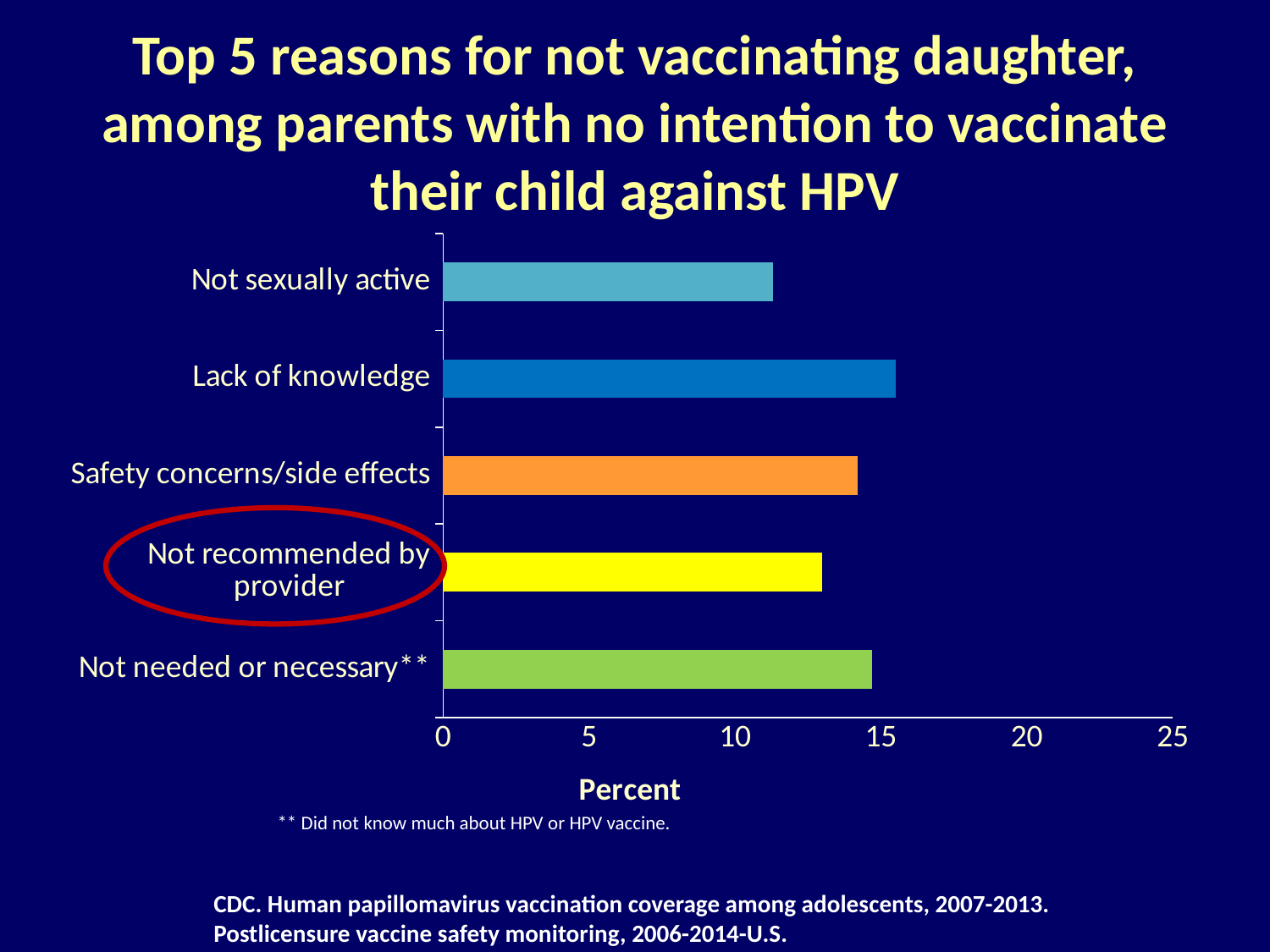
What kind of chart is shown on the slide? bar chart How many reasons (categories) are plotted in the chart? 5 Is the value for Not sexually active greater or less than 10? greater What is the label of the horizontal axis? Percent Which has a larger value: Not needed or necessary** or Not recommended by provider? Not needed or necessary** Which has a larger value: Lack of knowledge or Not sexually active? Lack of knowledge Is the value for Lack of knowledge greater or less than 20? less Which reason has the lowest percentage in the chart? Not sexually active Is the value for Safety concerns/side effects greater or less than 15? less Which category label is circled in red on the slide? Not recommended by provider Which reason has the highest percentage in the chart? Lack of knowledge